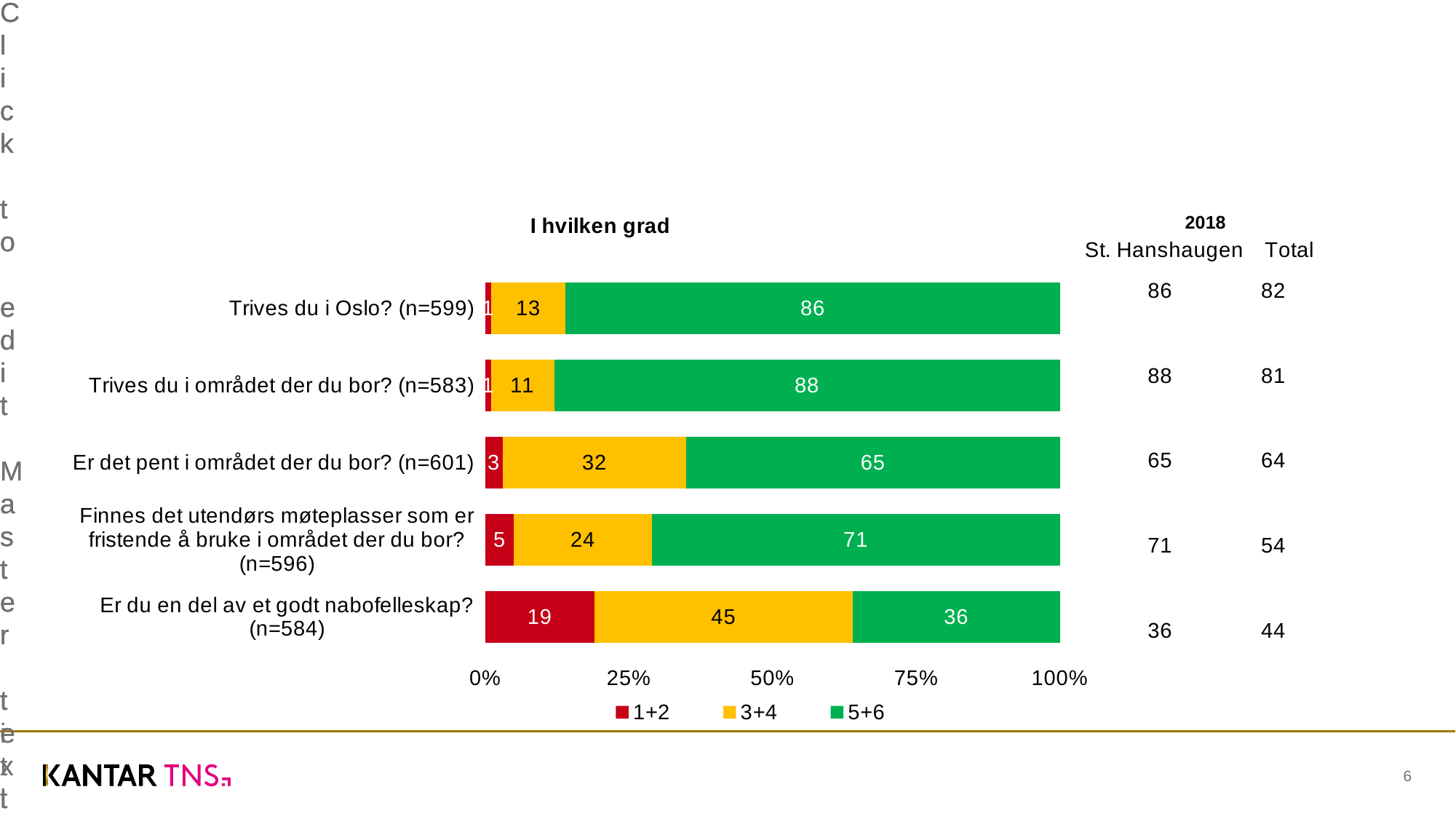
How many series does the legend list? 3 Which category has the lowest 5+6 value? Er du en del av et godt nabofelleskap? (n=584) What is the 1+2 value for "Er du en del av et godt nabofelleskap? (n=584)"? 19 What kind of chart is shown on the slide? stacked bar chart What is the title of the chart? I hvilken grad What is the difference between the 5+6 values for "Trives du i Oslo? (n=599)" and "Er det pent i området der du bor? (n=601)"? 21 Which category has the highest 5+6 value? Trives du i området der du bor? (n=583) What colour represents the 5+6 series in the chart? green What is the 3+4 value for "Er det pent i området der du bor? (n=601)"? 32 Which is larger: the 3+4 value for "Finnes det utendørs møteplasser som er fristende å bruke i området der du bor? (n=596)" or the 3+4 value for "Trives du i Oslo? (n=599)"? Finnes det utendørs møteplasser som er fristende å bruke i området der du bor? (n=596) What is the 5+6 value for "Trives du i området der du bor? (n=583)"? 88 How many categories (questions) are plotted in the chart? 5